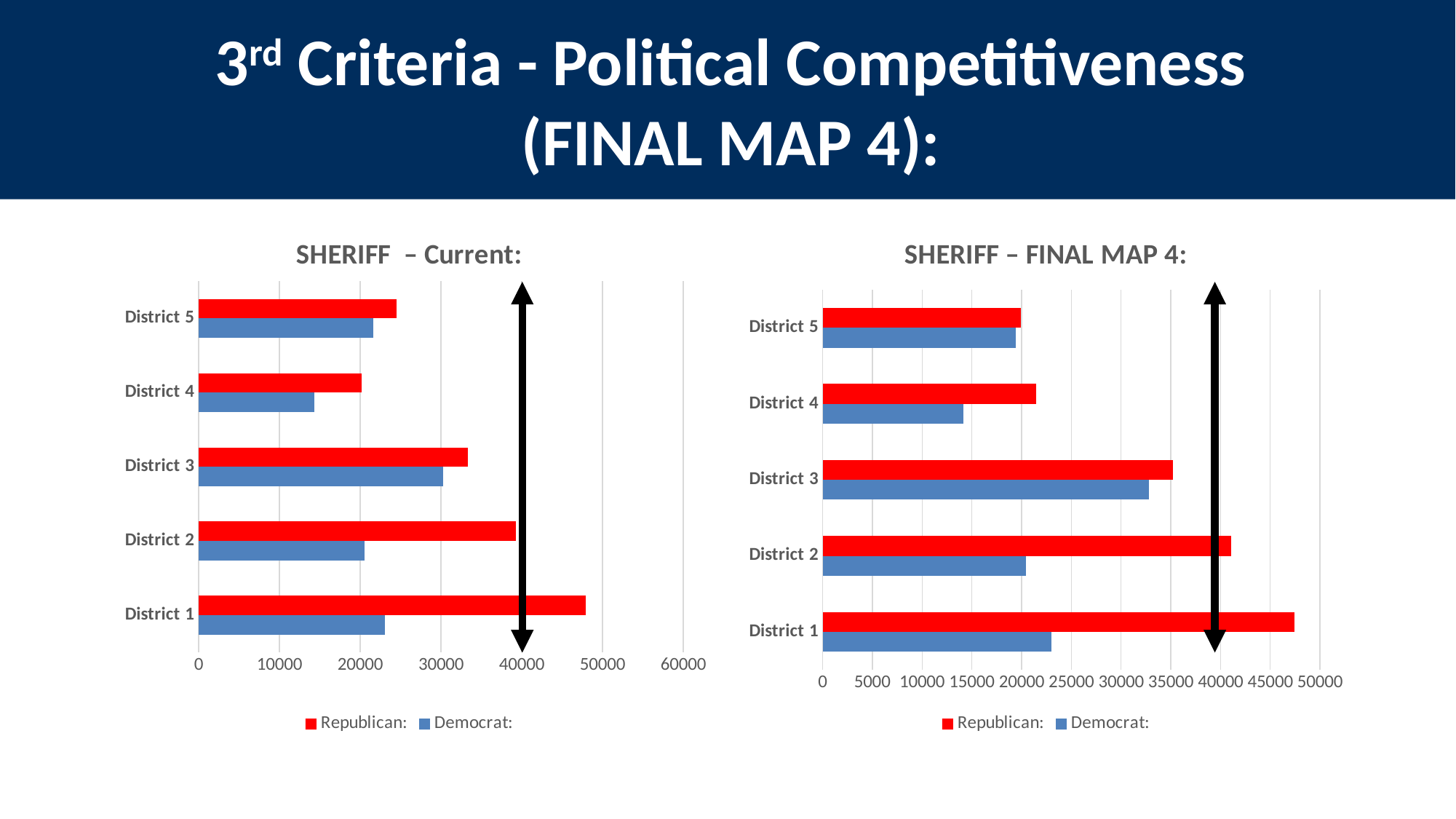
On the SHERIFF – Current chart, how many districts are plotted? 5 On the SHERIFF – Current chart, is the Republican value for District 1 greater or less than 40000? greater On the SHERIFF – Current chart, which district has the lowest Democrat value? District 4 On the SHERIFF – FINAL MAP 4 chart, is the Democrat value for District 4 greater or less than 20000? less On the SHERIFF – Current chart, what kind of chart is shown? bar chart On the SHERIFF – Current chart, how many series does the legend list? 2 On the SHERIFF – FINAL MAP 4 chart, which district has the highest Republican value? District 1 On the SHERIFF – FINAL MAP 4 chart, is the Republican value for District 3 greater or less than 30000? greater On the SHERIFF – FINAL MAP 4 chart, which colour represents the Democrat series? blue On the SHERIFF – FINAL MAP 4 chart, which district has the lowest Democrat value? District 4 On the SHERIFF – Current chart, which district has the highest Republican value? District 1 On the SHERIFF – Current chart, for District 2, which is larger: the Republican value or the Democrat value? Republican